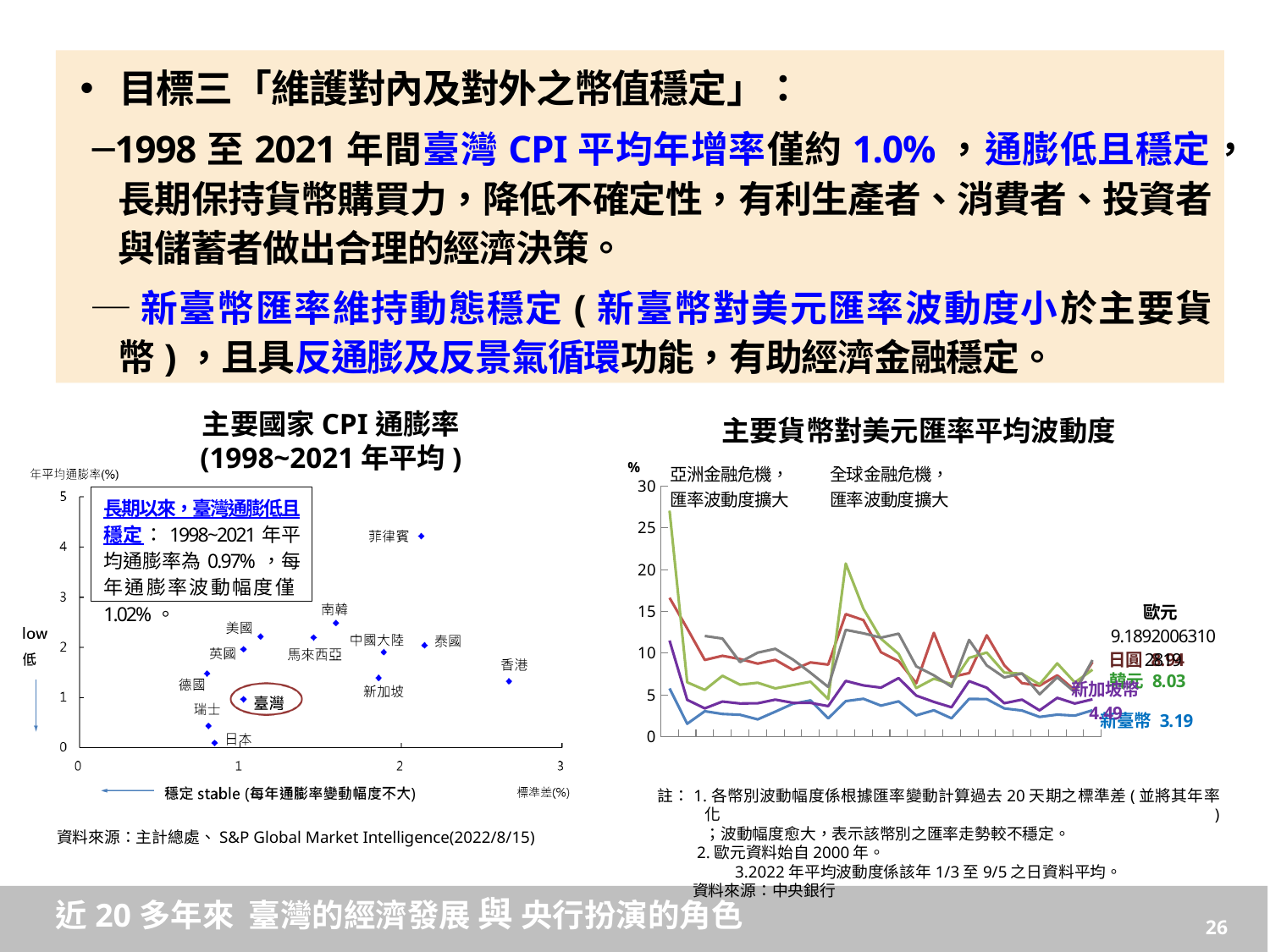
According to the text box in the left chart, what was Taiwan's average inflation rate for 1998~2021? 0.97% In the right chart 主要貨幣對美元匯率平均波動度, what is the labelled end value for 新加坡幣? 4.49 In the left chart 主要國家 CPI 通膨率, which economy has the largest standard deviation (furthest right on the x axis)? 香港 In the left chart 主要國家 CPI 通膨率, which country has the lowest average annual inflation rate? 日本 In the right chart 主要貨幣對美元匯率平均波動度, what is the labelled end value for 韓元? 8.03 In the right chart 主要貨幣對美元匯率平均波動度, what is the labelled end value for 新臺幣? 3.19 In the right chart 主要貨幣對美元匯率平均波動度, what is the difference between the end values of 新加坡幣 and 新臺幣? 1.30 In the left chart 主要國家 CPI 通膨率, which country has the highest average annual inflation rate? 菲律賓 In the left chart 主要國家 CPI 通膨率, is the standard deviation for 香港 greater or less than 2? greater According to the text box in the left chart, what was the annual volatility of Taiwan's inflation rate? 1.02% What kind of chart is the right chart titled 主要貨幣對美元匯率平均波動度? line chart What kind of chart is the left chart titled 主要國家 CPI 通膨率 (1998~2021 年平均)? scatter chart